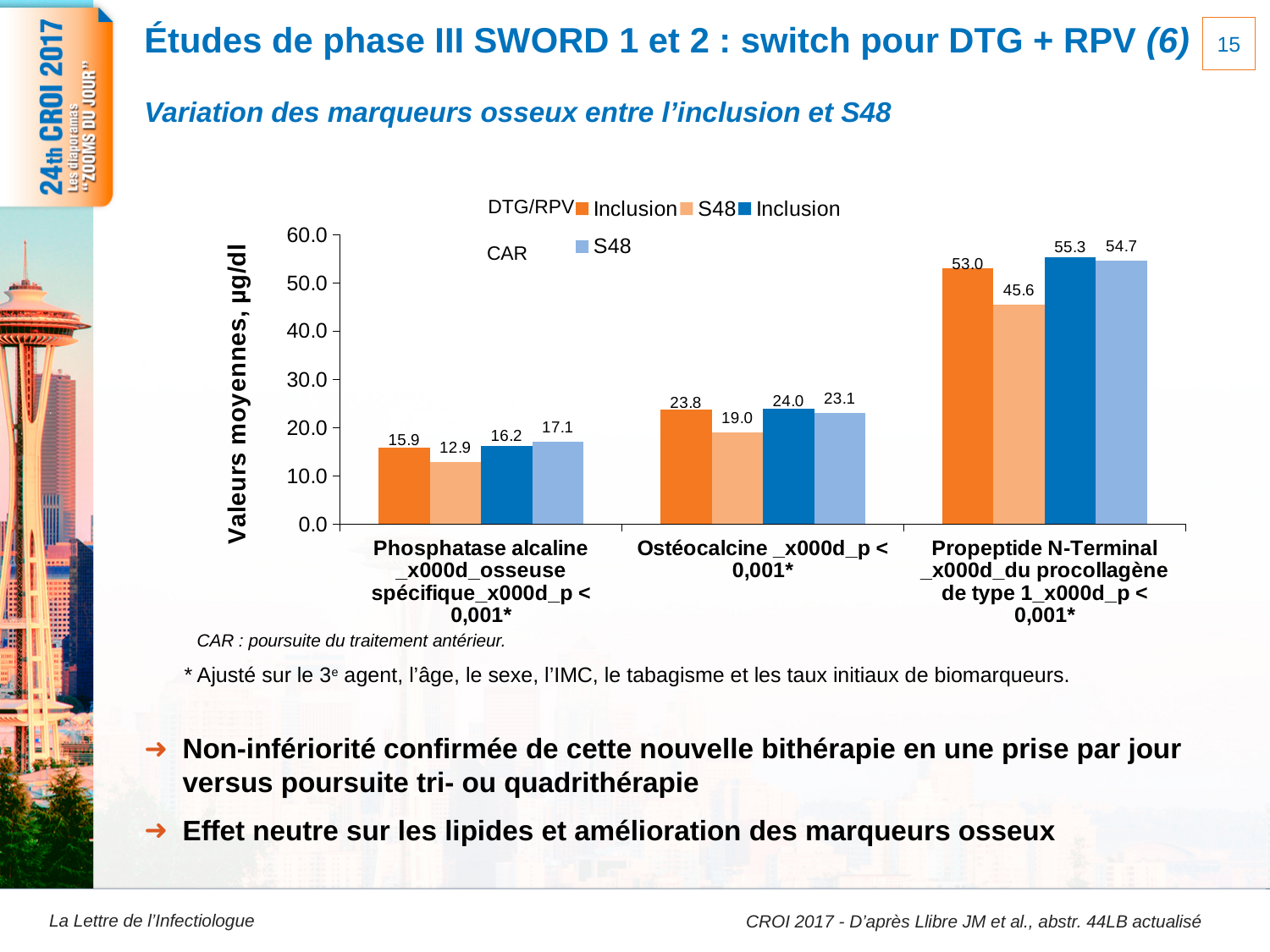
What is the CAR Inclusion value for Propeptide N-Terminal du procollagène de type 1? 55.3 For Ostéocalcine, which is larger: the DTG/RPV S48 value or the CAR S48 value? CAR S48 Which bone marker has the highest DTG/RPV Inclusion value? Propeptide N-Terminal du procollagène de type 1 What is the DTG/RPV Inclusion value for Ostéocalcine? 23.8 What is the DTG/RPV S48 value for Phosphatase alcaline osseuse spécifique? 12.9 How many series does the chart's legend list? 4 What is the difference between the DTG/RPV Inclusion and DTG/RPV S48 values for Propeptide N-Terminal du procollagène de type 1? 7.4 What is the label of the y axis of the chart? Valeurs moyennes, µg/dl What type of chart is shown on the slide? bar chart Which bone marker has the lowest DTG/RPV S48 value? Phosphatase alcaline osseuse spécifique What is the CAR S48 value for Ostéocalcine? 23.1 How many bone marker categories are shown on the x axis of the chart? 3